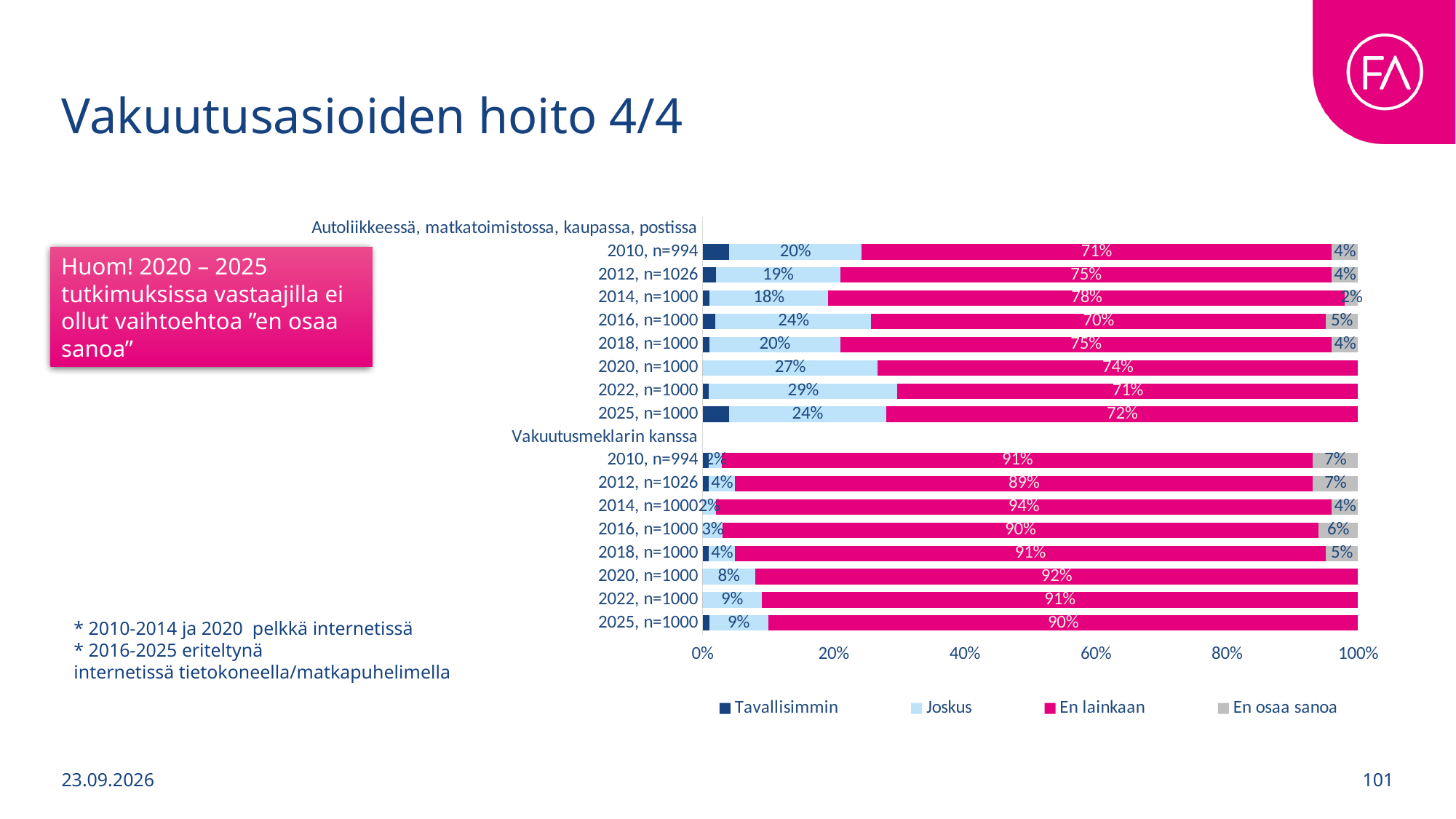
What is the 'En lainkaan' value for '2014, n=1000' in the 'Autoliikkeessä, matkatoimistossa, kaupassa, postissa' group? 78% What is the 'Joskus' value for '2022, n=1000' in the 'Autoliikkeessä, matkatoimistossa, kaupassa, postissa' group? 29% In the 'Vakuutusmeklarin kanssa' group, is the 'En lainkaan' value larger for '2012, n=1026' or for '2020, n=1000'? 2020, n=1000 How many bars are plotted in the chart in total? 16 Which year in the 'Autoliikkeessä, matkatoimistossa, kaupassa, postissa' group has the lowest 'Joskus' value? 2014, n=1000 What kind of chart is shown on the slide? Stacked bar chart Which legend entry is shown in pink? En lainkaan What is the difference between the 'En lainkaan' values for '2014, n=1000' and '2016, n=1000' in the 'Autoliikkeessä, matkatoimistossa, kaupassa, postissa' group? 8 percentage points What is the 'En osaa sanoa' value for '2010, n=994' in the 'Vakuutusmeklarin kanssa' group? 7% Which year in the 'Autoliikkeessä, matkatoimistossa, kaupassa, postissa' group has the highest 'Joskus' value? 2022, n=1000 How many series does the legend list? 4 What is the 'En lainkaan' value for '2014, n=1000' in the 'Vakuutusmeklarin kanssa' group? 94%